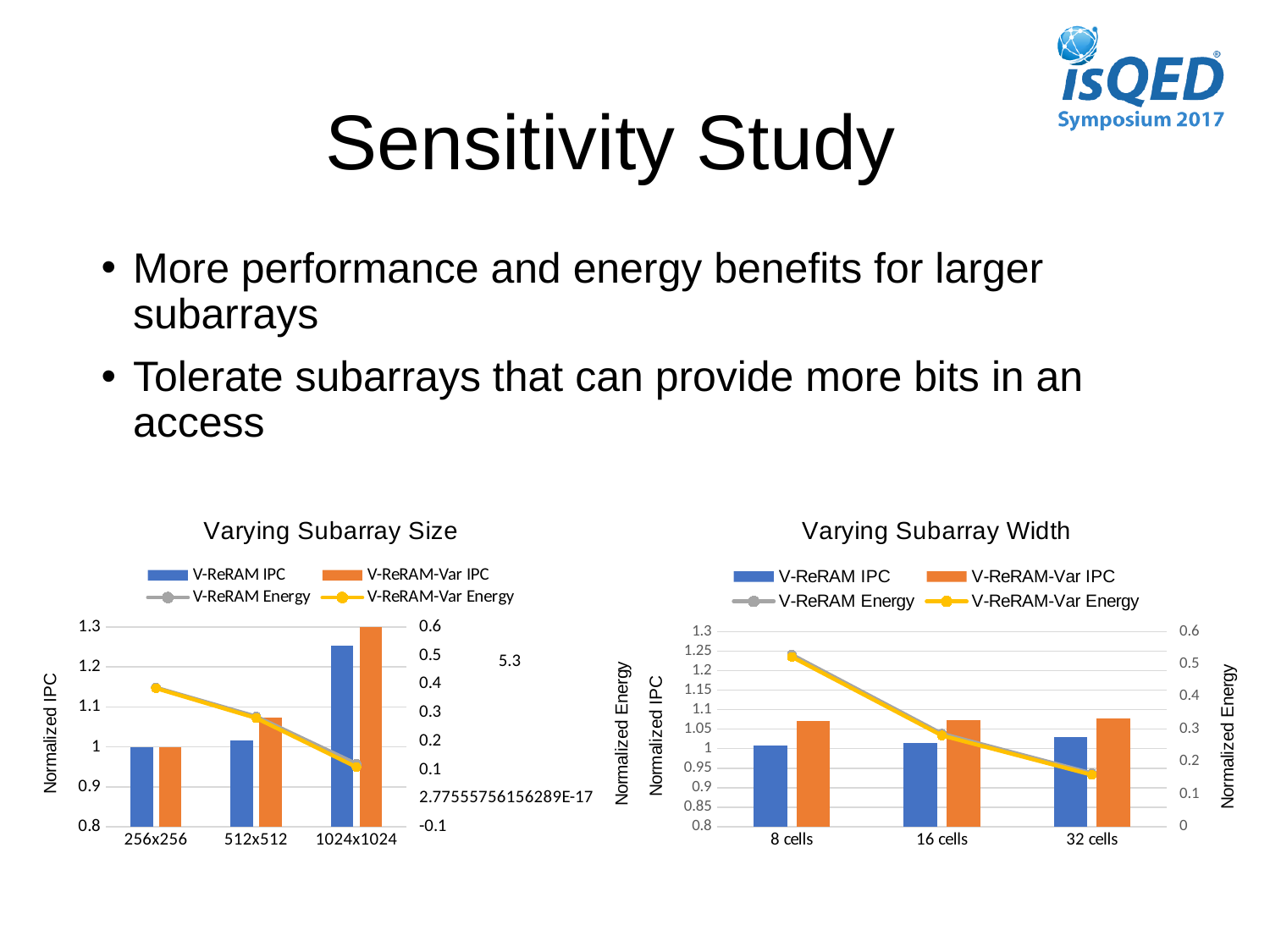
In the "Varying Subarray Width" chart, is the V-ReRAM Energy for 8 cells greater or less than 0.4? greater How many series does the legend of the "Varying Subarray Size" chart list? 4 In the "Varying Subarray Size" chart, is the V-ReRAM IPC for 256x256 greater or less than 1.1? less In the "Varying Subarray Width" chart, do the energy lines rise or fall from 8 cells to 32 cells? fall In the "Varying Subarray Size" chart, which subarray size has the highest V-ReRAM-Var IPC? 1024x1024 How many categories are shown on the x axis of the "Varying Subarray Width" chart? 3 How many subarray size categories are shown on the x axis of the "Varying Subarray Size" chart? 3 What kind of chart is the "Varying Subarray Size" chart? bar chart with line series In the "Varying Subarray Size" chart, at 1024x1024, which is larger: V-ReRAM IPC or V-ReRAM-Var IPC? V-ReRAM-Var IPC In the "Varying Subarray Size" chart, is the V-ReRAM-Var IPC for 1024x1024 greater or less than 1.2? greater What is the label of the left vertical axis on the "Varying Subarray Width" chart? Normalized IPC In the "Varying Subarray Size" chart, do the energy lines rise or fall as subarray size increases along the x axis? fall